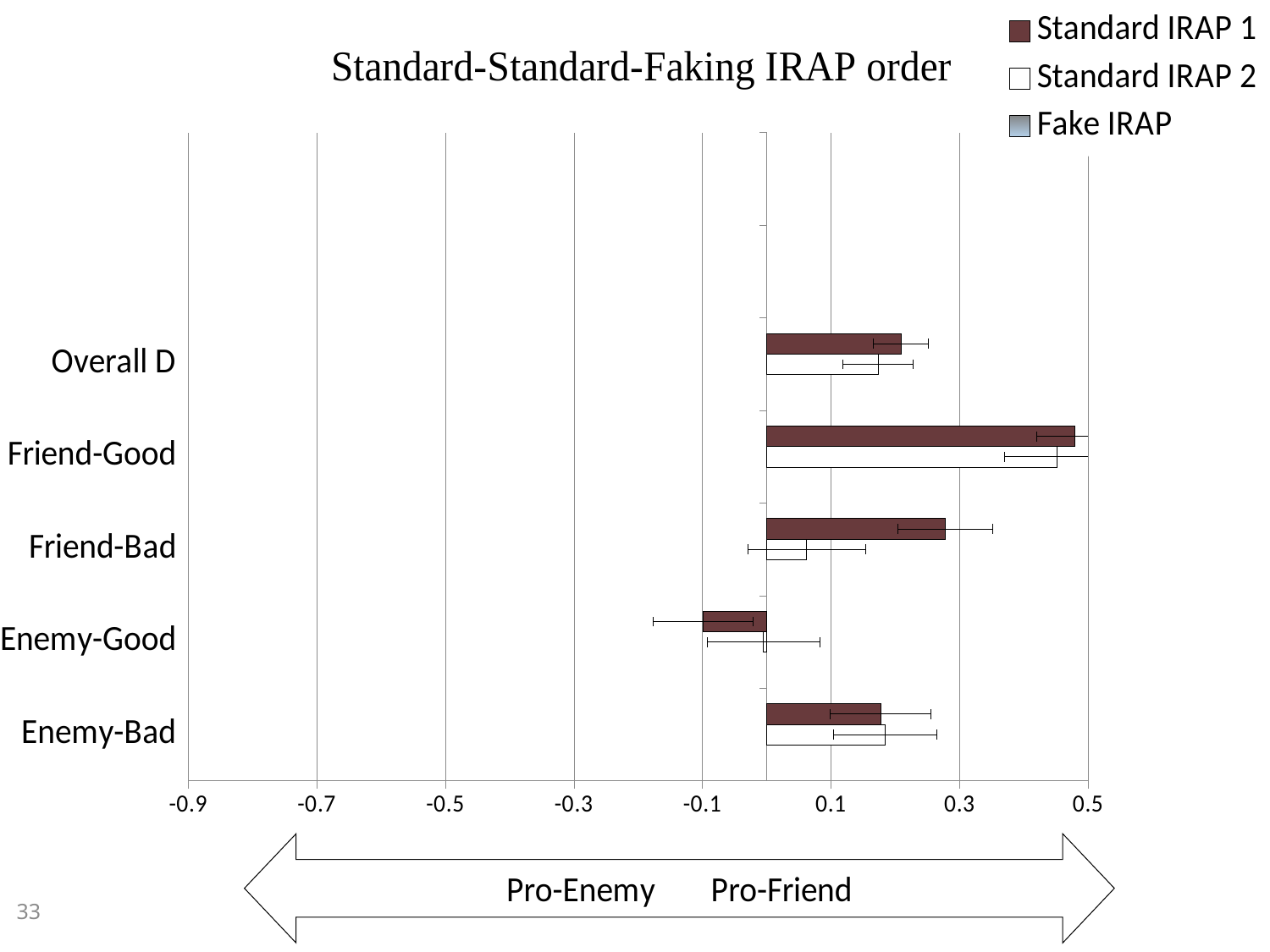
How many series does the legend list? 3 Is the Standard IRAP 1 value for Overall D greater or less than 0.1? greater How many categories are shown on the vertical axis of the chart? 5 Is the Standard IRAP 2 value for Friend-Bad greater or less than 0.1? less Is the Standard IRAP 1 value for Friend-Good greater or less than 0.3? greater Which category has the highest value for Standard IRAP 1? Friend-Good For Standard IRAP 1, which is larger, Friend-Good or Friend-Bad? Friend-Good Which category has the lowest value for Standard IRAP 1? Enemy-Good For Friend-Bad, which series has the larger value, Standard IRAP 1 or Standard IRAP 2? Standard IRAP 1 What kind of chart is shown on the slide? bar chart What two labels appear on the double-headed arrow below the x axis? Pro-Enemy and Pro-Friend What is the title of the chart? Standard-Standard-Faking IRAP order